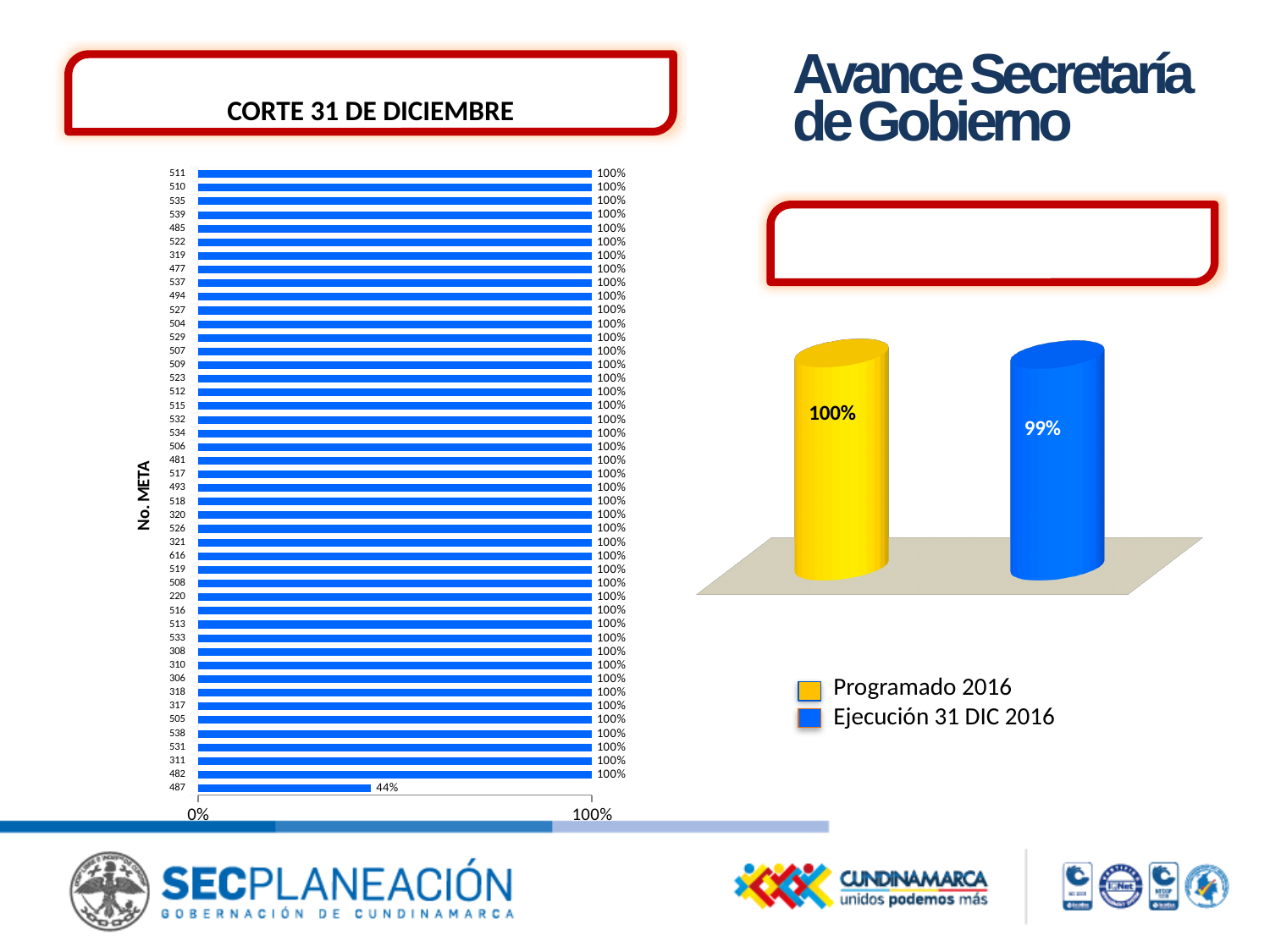
In the right chart (Avance Secretaría de Gobierno), what is the difference between Programado 2016 and Ejecución 31 DIC 2016? 1% In the left chart (CORTE 31 DE DICIEMBRE), what is the difference between the value for meta 482 and the value for meta 487? 56% In the left chart (CORTE 31 DE DICIEMBRE), what is the value for meta 487? 44% In the left chart (CORTE 31 DE DICIEMBRE), what is the label of the vertical axis? No. META In the left chart (CORTE 31 DE DICIEMBRE), which is larger, the value for meta 311 or the value for meta 487? 311 In the right chart (Avance Secretaría de Gobierno), how many entries does the legend list? 2 In the right chart (Avance Secretaría de Gobierno), what is the value for Ejecución 31 DIC 2016? 99% In the left chart (CORTE 31 DE DICIEMBRE), which meta has the lowest value? 487 What kind of chart is the left chart (CORTE 31 DE DICIEMBRE)? Bar chart In the left chart (CORTE 31 DE DICIEMBRE), what is the value for meta 511? 100% In the right chart (Avance Secretaría de Gobierno), what colour is the Programado 2016 bar? Yellow In the right chart (Avance Secretaría de Gobierno), what is the value for Programado 2016? 100%